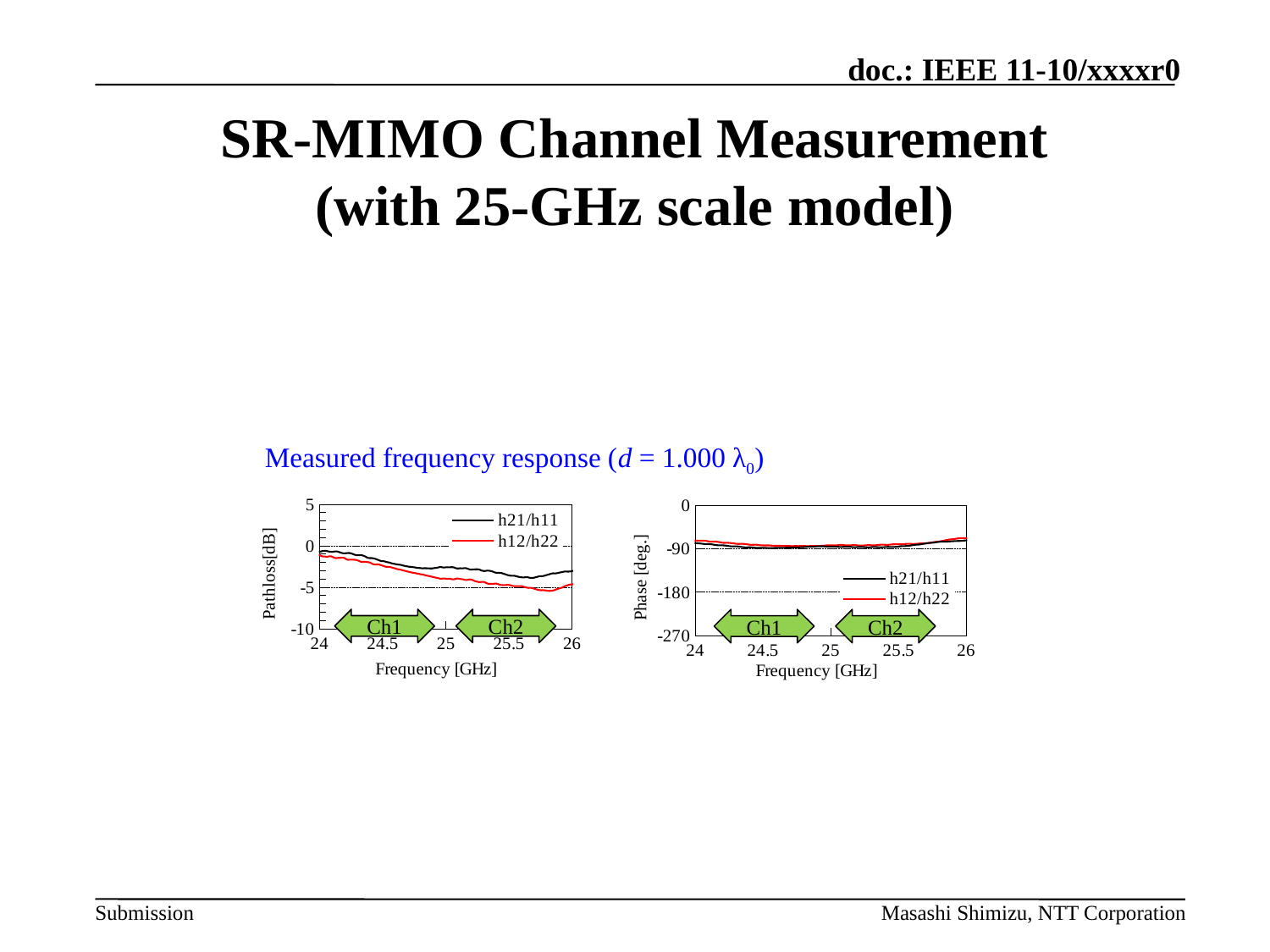
What kind of chart is the right chart (Phase [deg.] vs Frequency)? line chart What are the two series named in the legend of the right Phase chart? h21/h11 and h12/h22 In the left Pathloss chart, does the h12/h22 line generally rise or fall as frequency increases from 24 to 26 GHz? fall In the left Pathloss chart, is the h21/h11 value at 24 GHz greater or less than 0? less What is the x-axis label of the left Pathloss chart? Frequency [GHz] In the right Phase chart, is the h21/h11 value at 25 GHz greater or less than -180? greater What kind of chart is the left chart (Pathloss[dB] vs Frequency)? line chart In the right Phase chart, is the h12/h22 value at 24 GHz greater or less than -90? greater In the left Pathloss chart, at 25.5 GHz, which series has the higher pathloss value, h21/h11 or h12/h22? h21/h11 In the left Pathloss chart, which colour is the h12/h22 line? red How many series does the legend of the left Pathloss chart list? 2